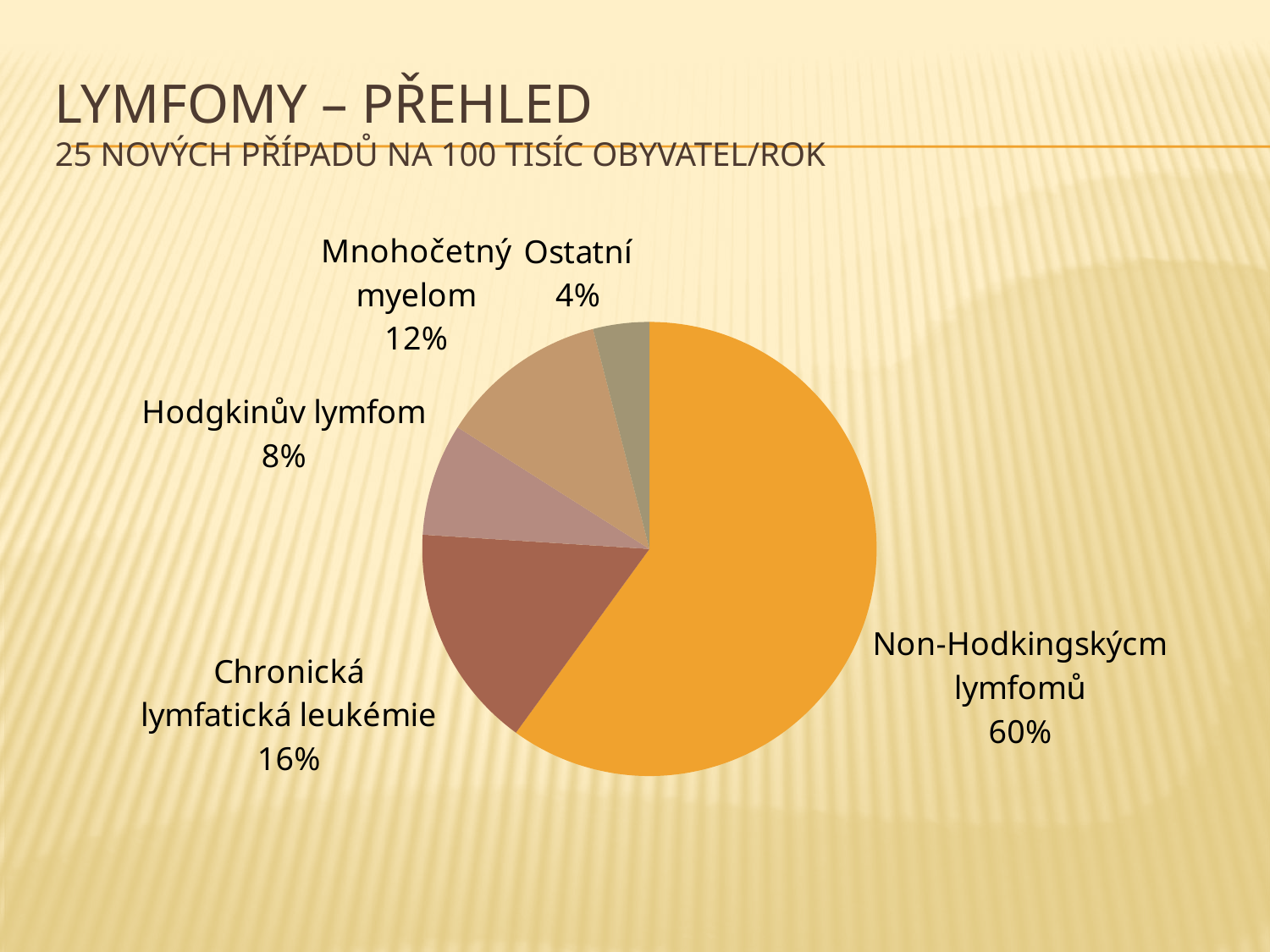
What kind of chart is shown on the slide? pie chart How many categories are shown in the pie chart? 5 What is the value shown for Hodgkinův lymfom? 8% Which category has the largest slice of the pie? Non-Hodkingskýcm lymfomů What is the difference between the values for Chronická lymfatická leukémie and Hodgkinův lymfom? 8% What is the value shown for Mnohočetný myelom? 12% Which category has the smallest slice of the pie? Ostatní What is the value shown for Chronická lymfatická leukémie? 16% What share of the pie does Non-Hodgkingskýcm lymfomů have? 60% What is the value shown for Ostatní? 4% Which is larger, the value for Mnohočetný myelom or the value for Hodgkinův lymfom? Mnohočetný myelom What is the title of the slide? LYMFOMY – PŘEHLED